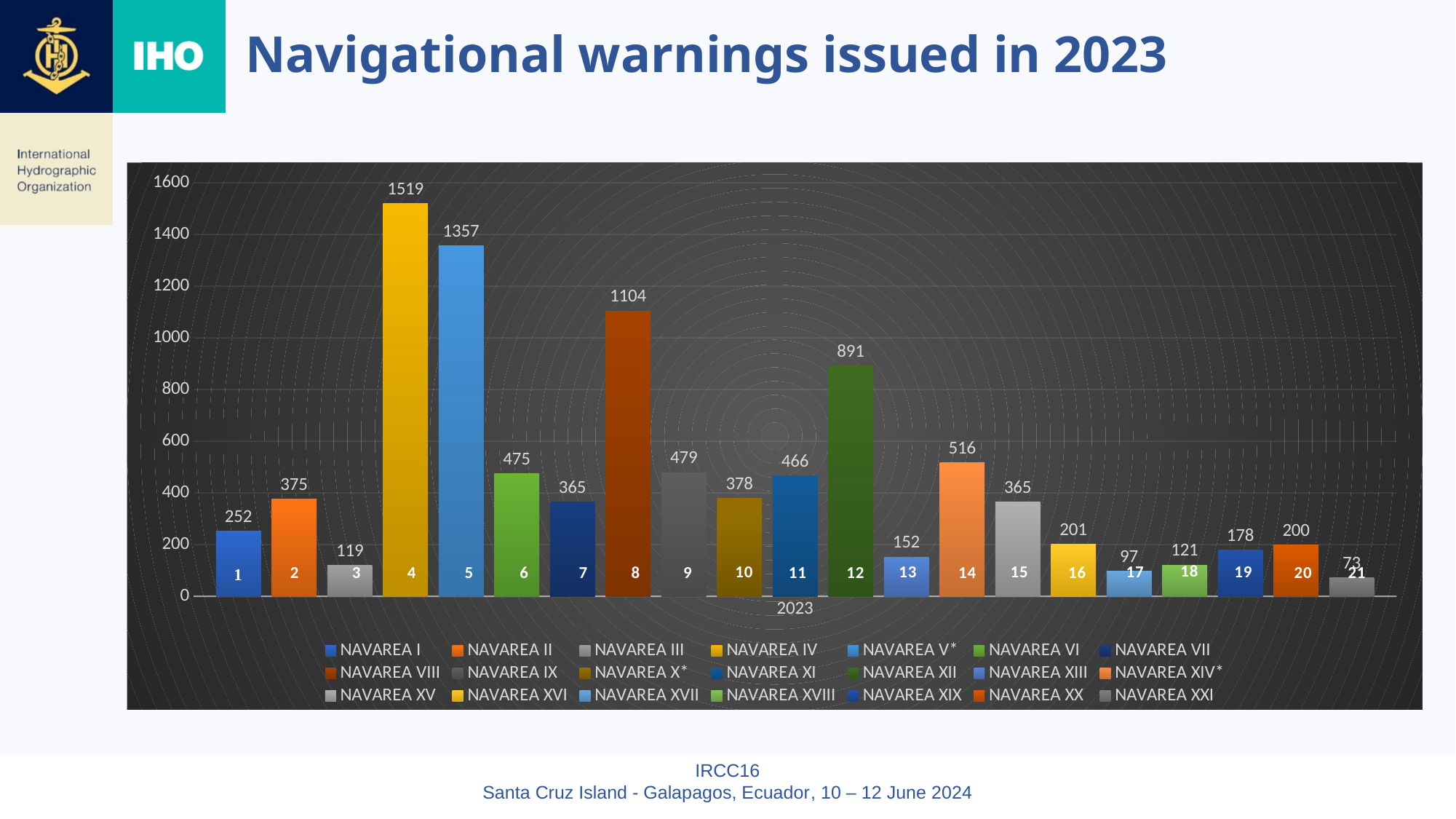
How many navigational warnings were issued by NAVAREA IV in 2023? 1519 How many series does the legend list? 21 What is the value shown for NAVAREA XXI? 73 What is the difference between the values for NAVAREA IV and NAVAREA V*? 162 What is the value shown for NAVAREA VIII? 1104 Which NAVAREA issued the most navigational warnings in 2023? NAVAREA IV What is the value shown for NAVAREA XVII? 97 What type of chart is shown on the slide? bar chart What is the difference between the values for NAVAREA II and NAVAREA I? 123 Which NAVAREA issued the fewest navigational warnings in 2023? NAVAREA XXI What year is shown on the horizontal axis of the chart? 2023 Which has a higher value, NAVAREA XII or NAVAREA XIV*? NAVAREA XII